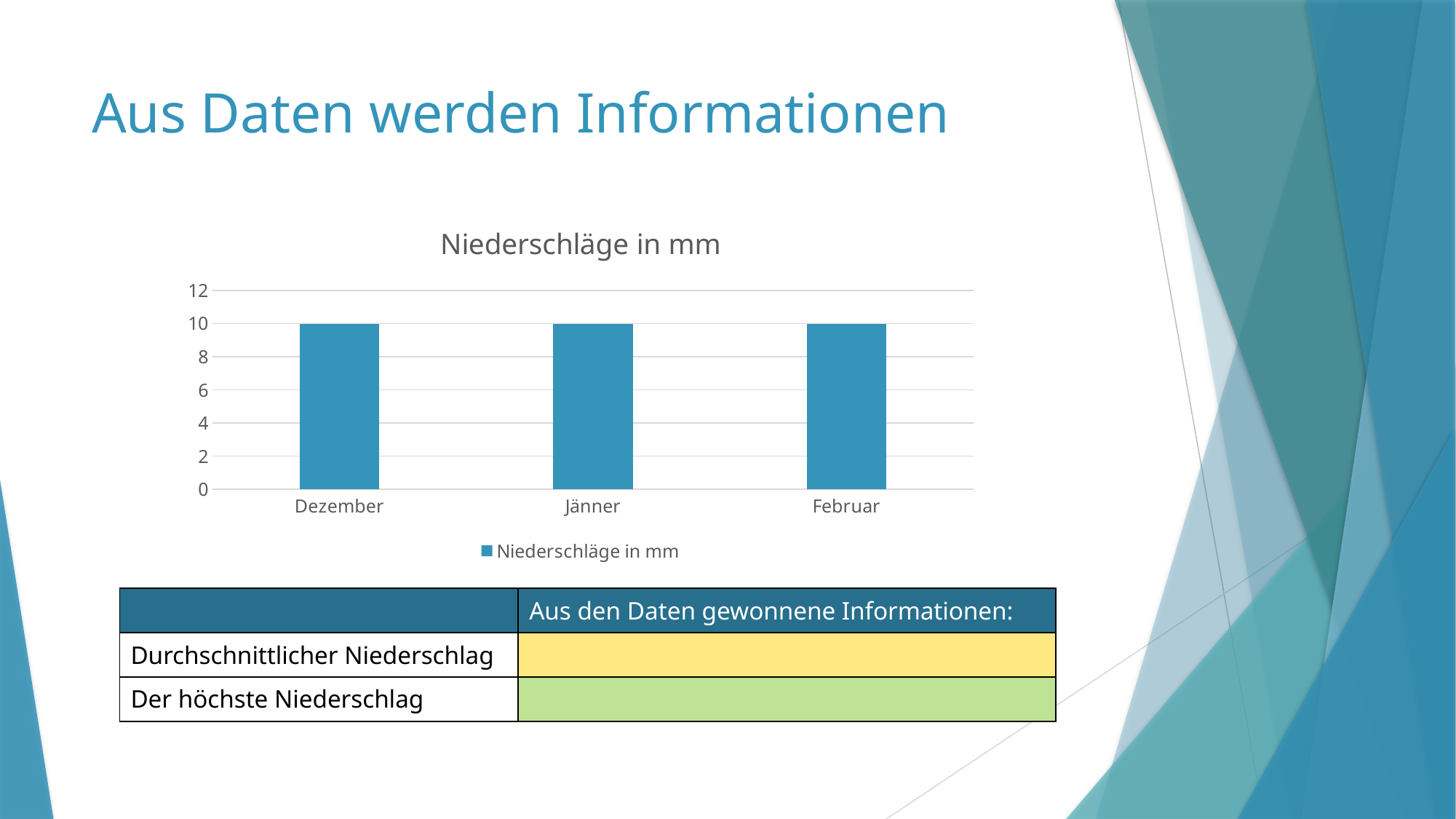
Is the value for Februar greater or less than 12? less What is the name of the series listed in the chart's legend? Niederschläge in mm How many categories are shown on the x axis of the chart? 3 How many series does the chart's legend list? 1 What is the value for Dezember in the chart? 10 What is the title of the chart? Niederschläge in mm Is the value for Jänner greater or less than 8? greater What is the value for Februar in the chart? 10 What is the value for Jänner in the chart? 10 What is the difference between the values for Dezember and Februar? 0 What kind of chart is shown on the slide? bar chart Do the values rise, fall, or stay flat from Dezember to Februar? stay flat